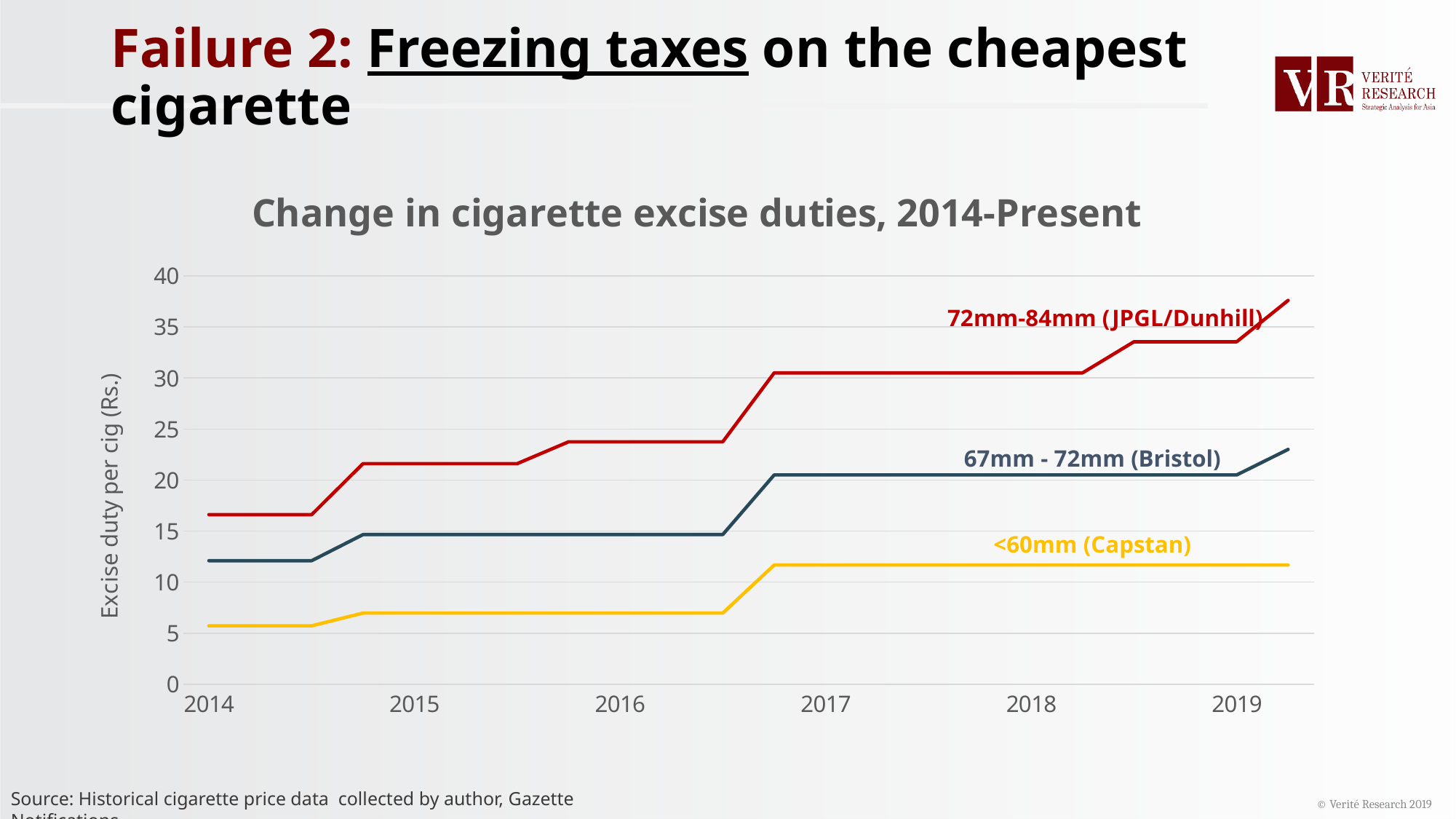
Is the excise duty for 72mm-84mm (JPGL/Dunhill) in 2019 greater or less than 30? greater What type of chart is shown on the slide? Line chart Is the excise duty for <60mm (Capstan) in 2014 greater or less than 10? less What is the label of the vertical axis? Excise duty per cig (Rs.) How many series (lines) are plotted on the chart? 3 What is the title of the chart? Change in cigarette excise duties, 2014-Present Which series has the highest excise duty throughout the period? 72mm-84mm (JPGL/Dunhill) In 2016, which series has the larger excise duty: 67mm - 72mm (Bristol) or <60mm (Capstan)? 67mm - 72mm (Bristol) Is the excise duty for 67mm - 72mm (Bristol) in 2018 greater or less than 15? greater Does the excise duty for 72mm-84mm (JPGL/Dunhill) rise or fall from 2014 to 2019? Rise Which series has the lowest excise duty throughout the period? <60mm (Capstan)